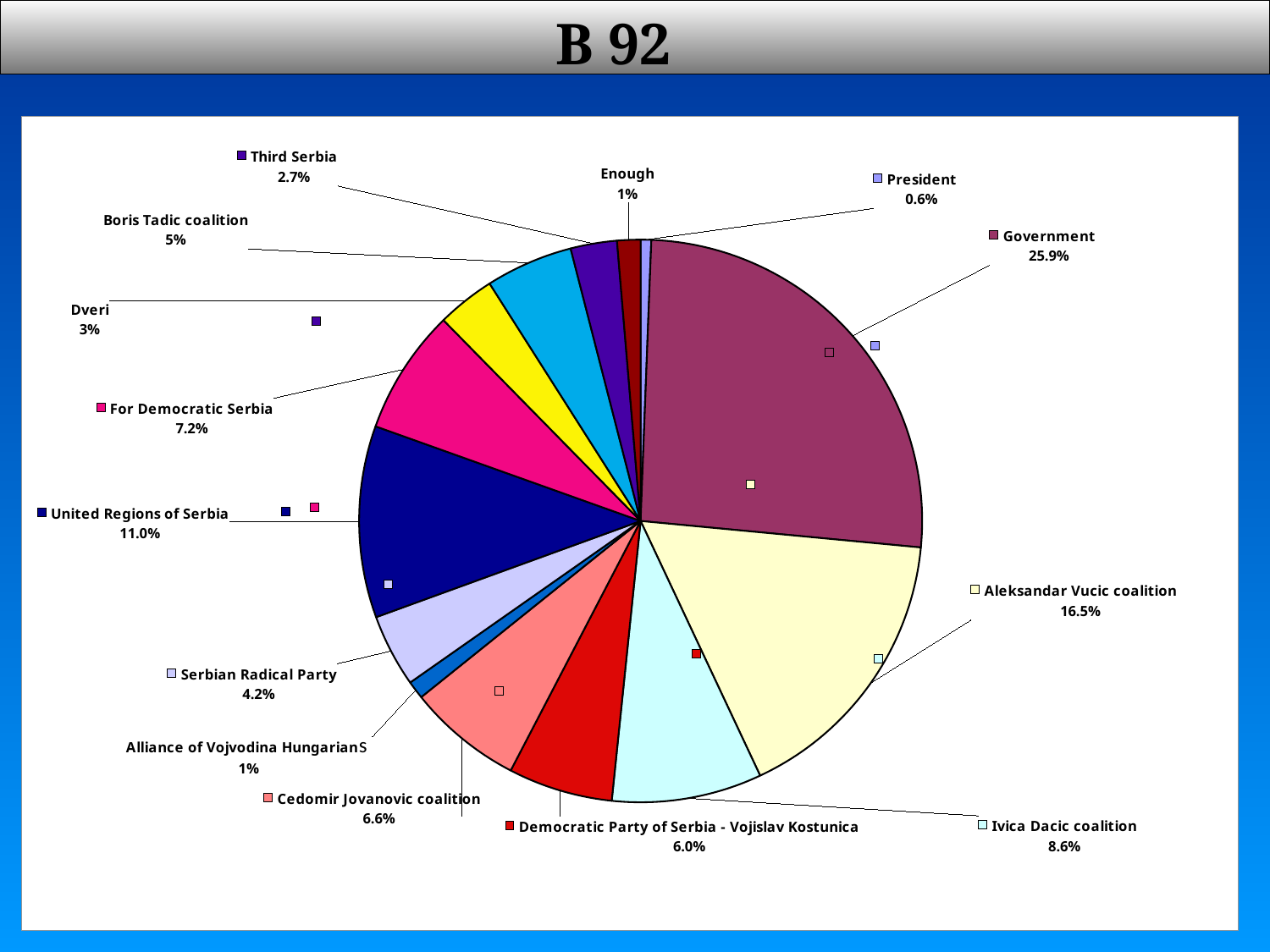
Which is larger, the Cedomir Jovanovic coalition or the Democratic Party of Serbia - Vojislav Kostunica? Cedomir Jovanovic coalition What is the title of the slide? B 92 Which category has the smallest slice of the pie? President How many slices does the pie chart have? 14 What is the value for United Regions of Serbia? 11.0% What is the difference between the Government share and the Aleksandar Vucic coalition share? 9.4% What is the value for President? 0.6% What kind of chart is shown on the slide? pie chart What is the value for the Ivica Dacic coalition? 8.6% What share of the pie does Government have? 25.9% Which category has the largest slice of the pie? Government What is the value for the Aleksandar Vucic coalition? 16.5%